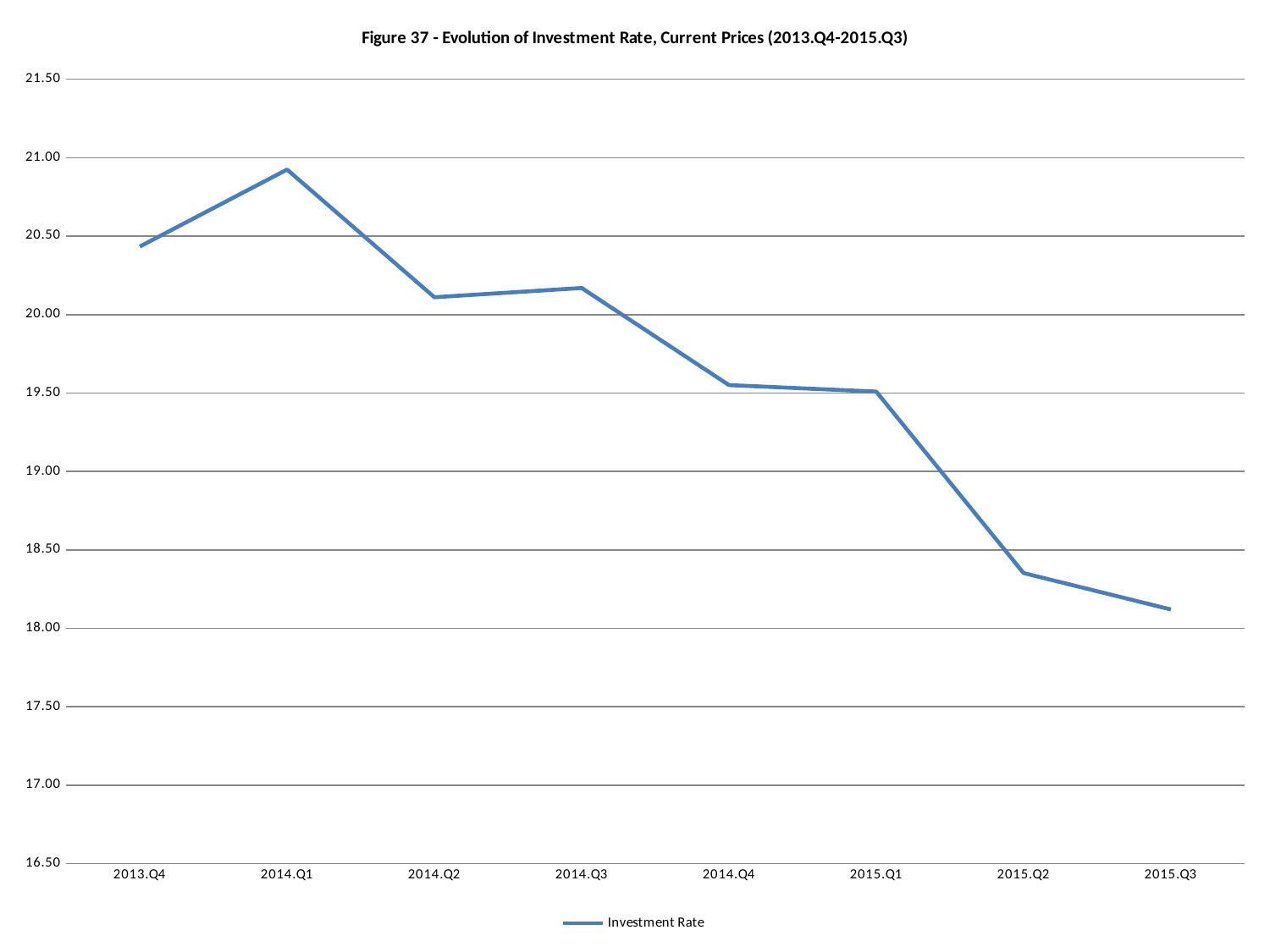
What kind of chart is shown on the slide? line chart How many quarters are plotted along the x axis? 8 How many series does the legend list? 1 What is the title of the chart? Figure 37 - Evolution of Investment Rate, Current Prices (2013.Q4-2015.Q3) Does the investment rate generally rise or fall from 2014.Q1 to 2015.Q3? fall Is the investment rate for 2013.Q4 greater or less than 20.00? greater Is the investment rate for 2014.Q4 greater or less than 19.00? greater Is the investment rate for 2014.Q1 greater or less than 20.50? greater In which quarter is the investment rate lowest? 2015.Q3 Which is larger, the investment rate in 2014.Q3 or in 2015.Q1? 2014.Q3 In which quarter is the investment rate highest? 2014.Q1